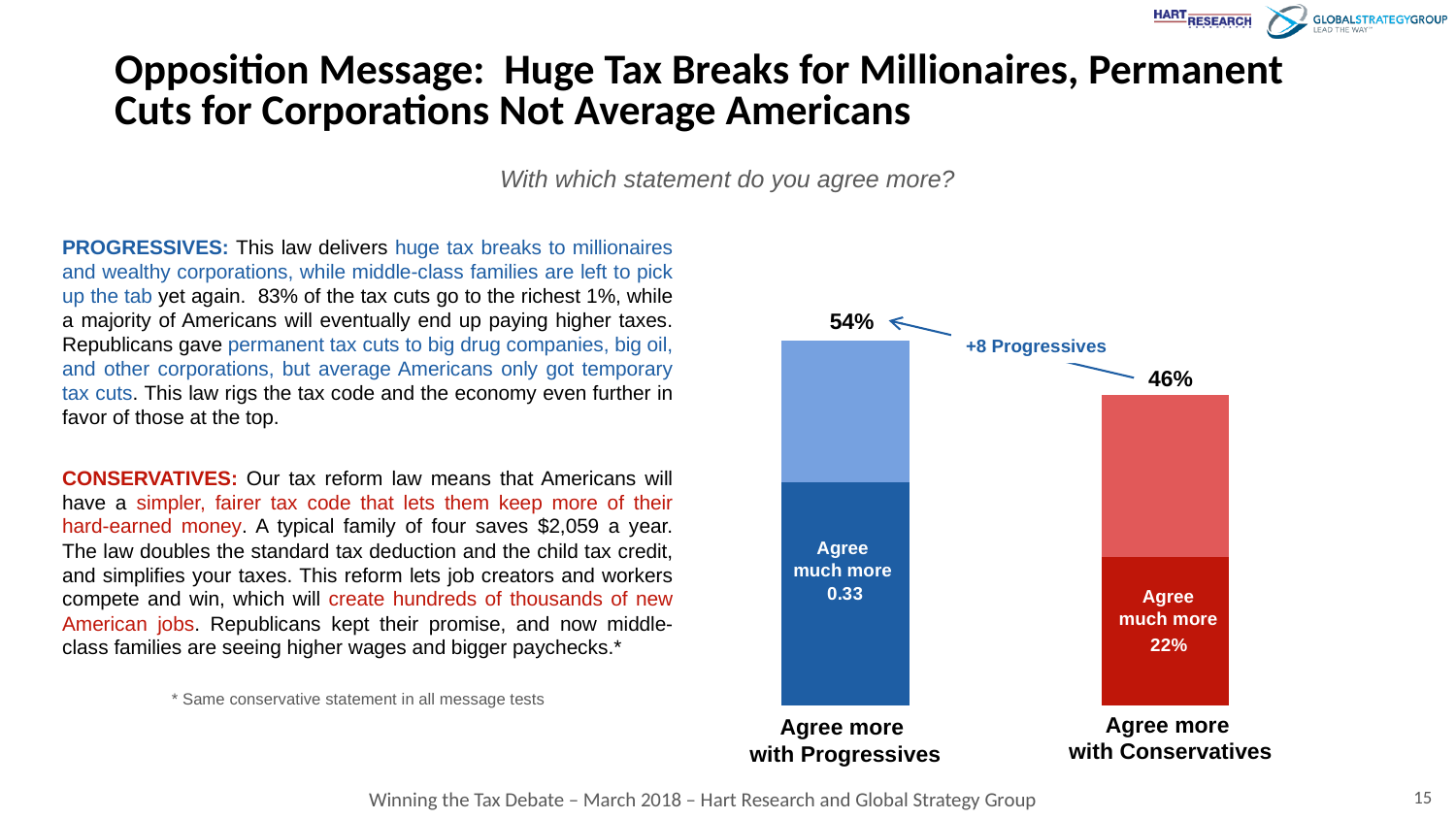
What colour is the 'Agree more with Conservatives' bar? Red How many bars are shown in the chart? 2 What percentage agrees more with Progressives? 54% What percentage agrees more with Conservatives? 46% What value is shown for the 'Agree much more' segment of the Conservatives bar? 22% What type of chart is shown on the slide? Stacked bar chart What does the annotation between the two bars say? +8 Progressives What is the difference between the Progressives total (54%) and the Conservatives total (46%)? 8 percentage points Is the total for 'Agree more with Progressives' larger or smaller than the total for 'Agree more with Conservatives'? larger Which bar has the higher total value? Agree more with Progressives Which bar has the lower total value? Agree more with Conservatives What value is printed on the 'Agree much more' segment of the Progressives bar? 0.33